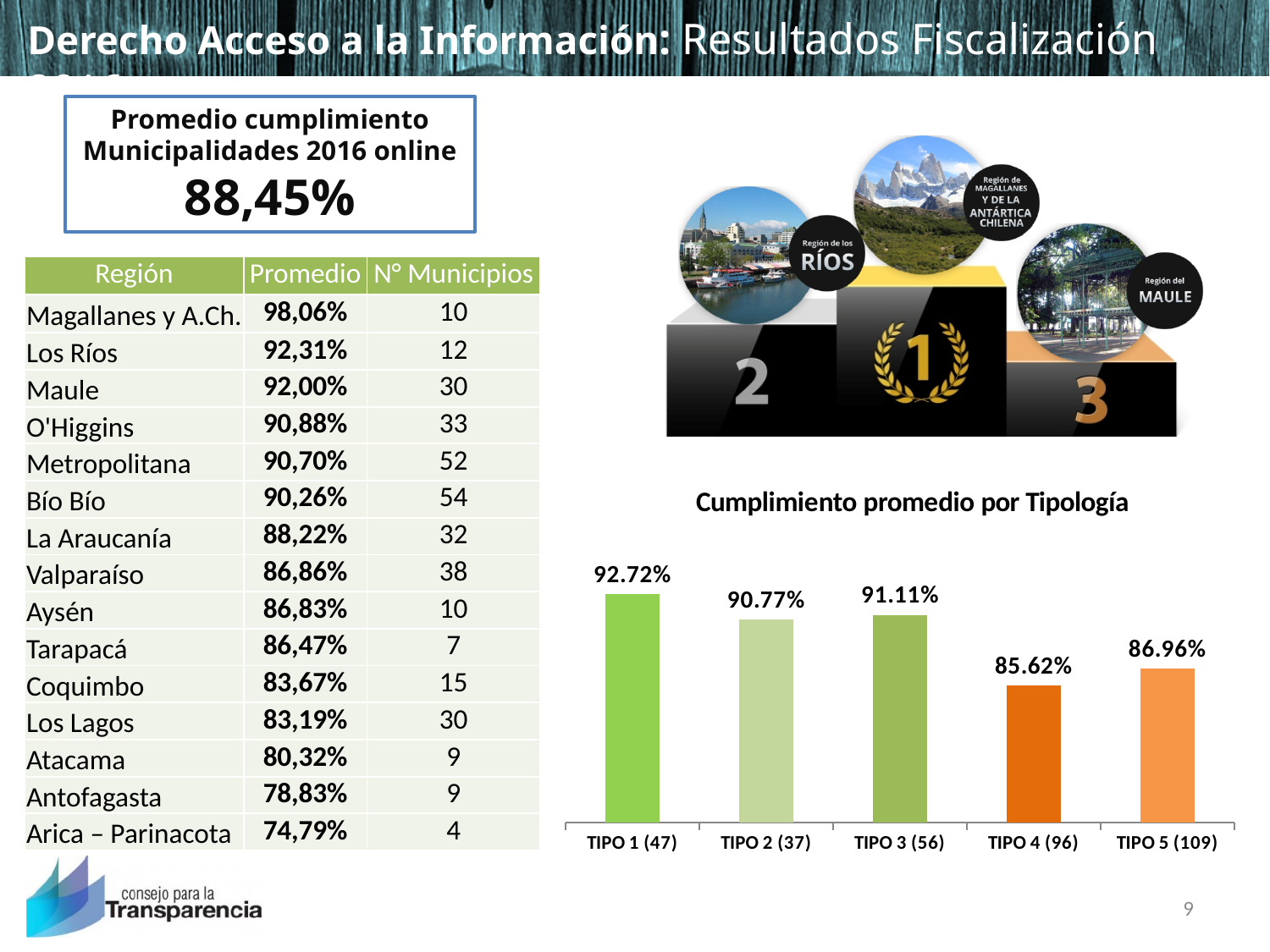
Which category has the lowest value in the chart 'Cumplimiento promedio por Tipología'? TIPO 4 (96) In the chart 'Cumplimiento promedio por Tipología', what is the difference between the values for TIPO 1 (47) and TIPO 4 (96)? 7.10% What is the value for TIPO 5 (109) in the chart 'Cumplimiento promedio por Tipología'? 86.96% What is the value for TIPO 1 (47) in the chart 'Cumplimiento promedio por Tipología'? 92.72% What is the value for TIPO 2 (37) in the chart 'Cumplimiento promedio por Tipología'? 90.77% How many categories are shown in the chart 'Cumplimiento promedio por Tipología'? 5 In the chart 'Cumplimiento promedio por Tipología', what is the difference between the values for TIPO 3 (56) and TIPO 2 (37)? 0.34% What is the title of the bar chart on the slide? Cumplimiento promedio por Tipología Which category has the highest value in the chart 'Cumplimiento promedio por Tipología'? TIPO 1 (47) What kind of chart is 'Cumplimiento promedio por Tipología'? Bar chart What is the value for TIPO 4 (96) in the chart 'Cumplimiento promedio por Tipología'? 85.62% In the chart 'Cumplimiento promedio por Tipología', which is larger, the value for TIPO 3 (56) or TIPO 2 (37)? TIPO 3 (56)